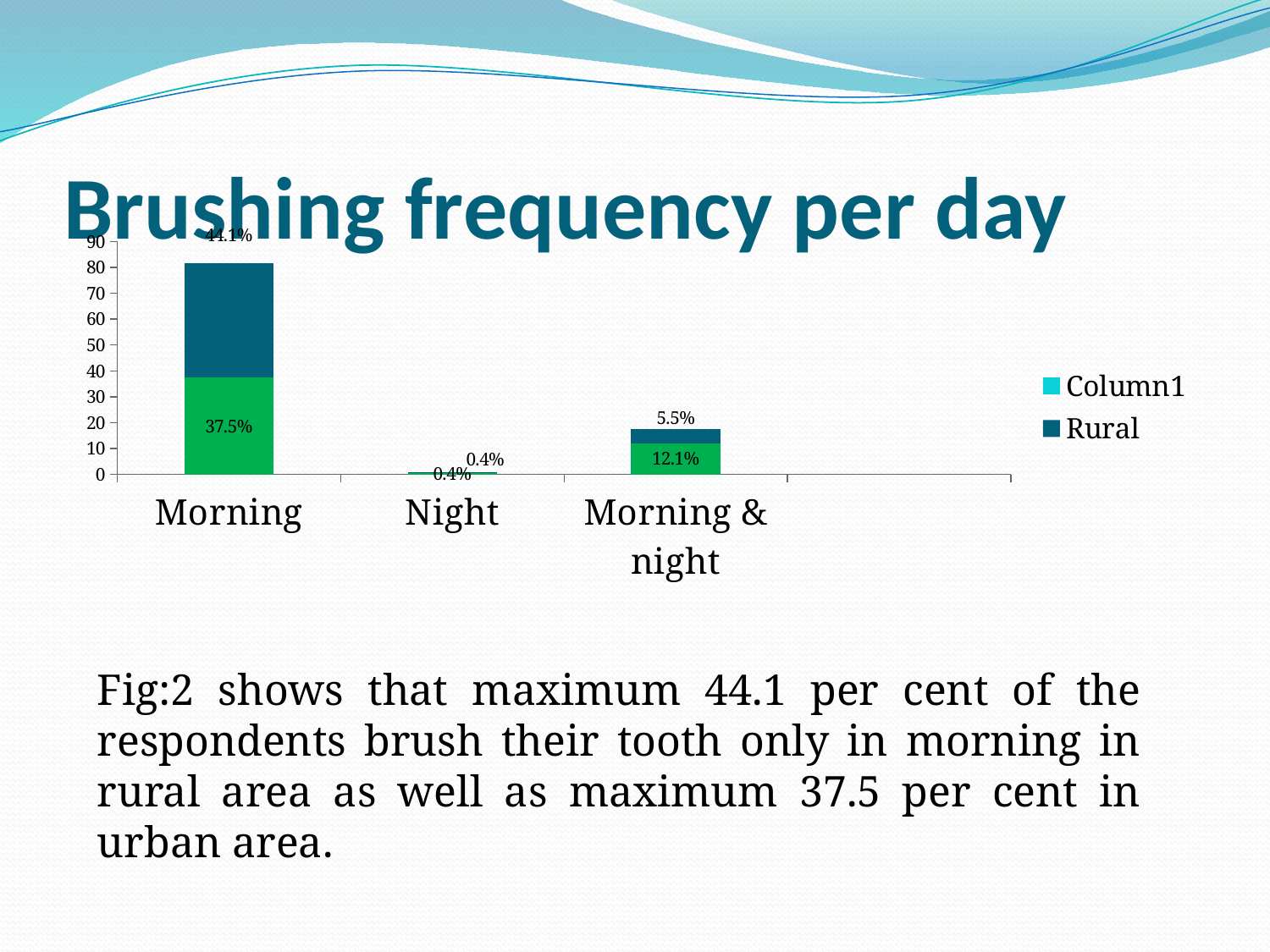
Which category has the highest Rural value? Morning How many series does the chart's legend list? 2 Which category has the lowest Rural value? Night What is the Rural value for Night? 0.4% What value is labelled on the green segment of the Morning & night bar? 12.1% What value is labelled on the green segment of the Morning bar? 37.5% What kind of chart is shown on the slide? Bar chart What is the Rural value for Morning? 44.1% What is the difference between the Rural value for Morning and the Rural value for Morning & night? 38.6 percentage points How many categories are shown on the x axis of the chart? 3 What are the entries listed in the chart's legend? Column1 and Rural What is the Rural value for Morning & night? 5.5%